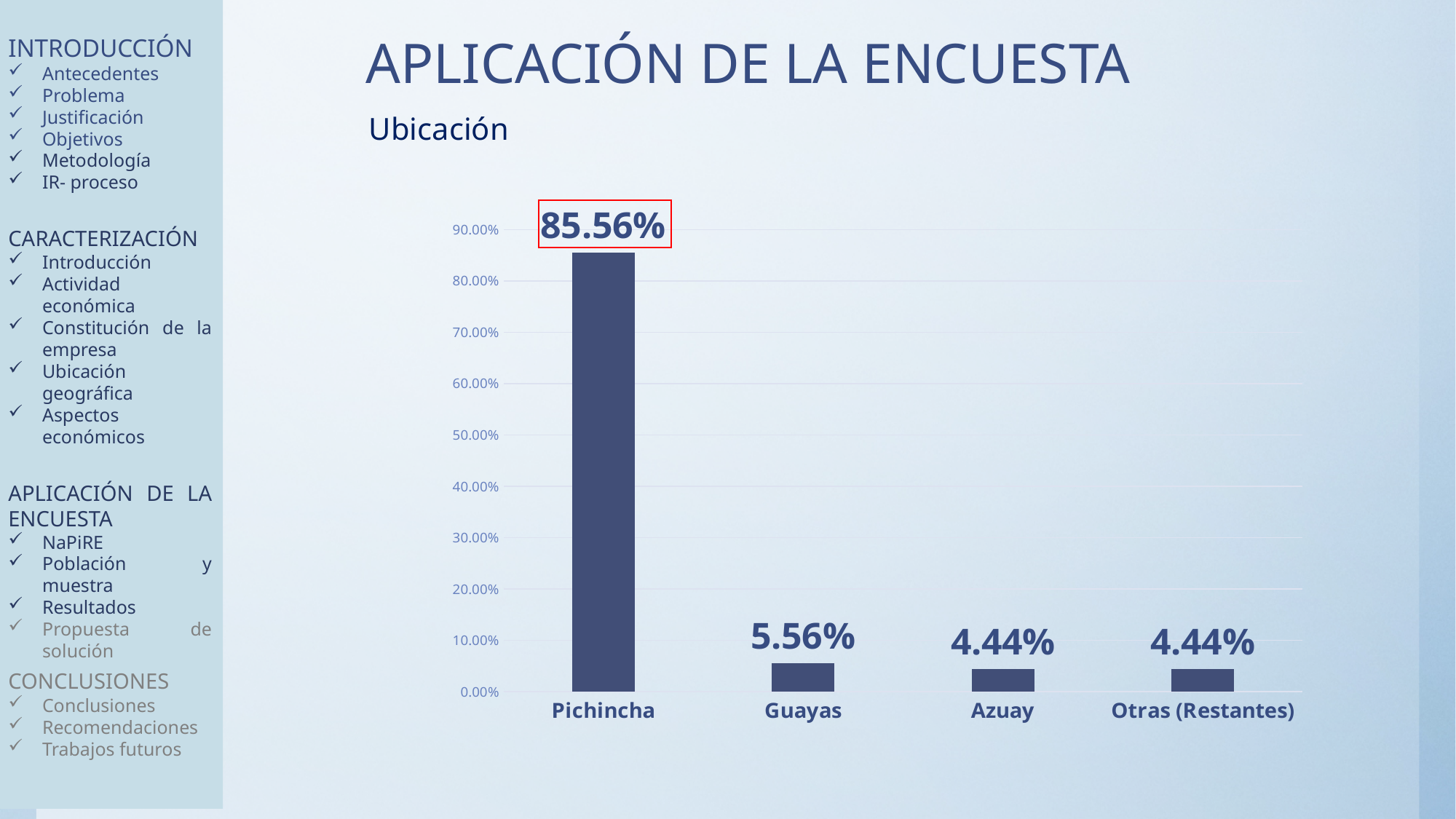
What kind of chart is shown on the slide? bar chart Which is larger, the value for Guayas or the value for Azuay? Guayas Is the value for Pichincha greater or less than 80.00%? greater What is the value for Guayas? 5.56% What is the value for Azuay? 4.44% What is the subtitle shown above the chart? Ubicación What is the difference between the values for Guayas and Azuay? 1.12% How many categories are shown on the x axis? 4 What is the value for Otras (Restantes)? 4.44% Which category has the highest value? Pichincha What is the value for Pichincha? 85.56% What is the difference between the values for Pichincha and Guayas? 80.00%